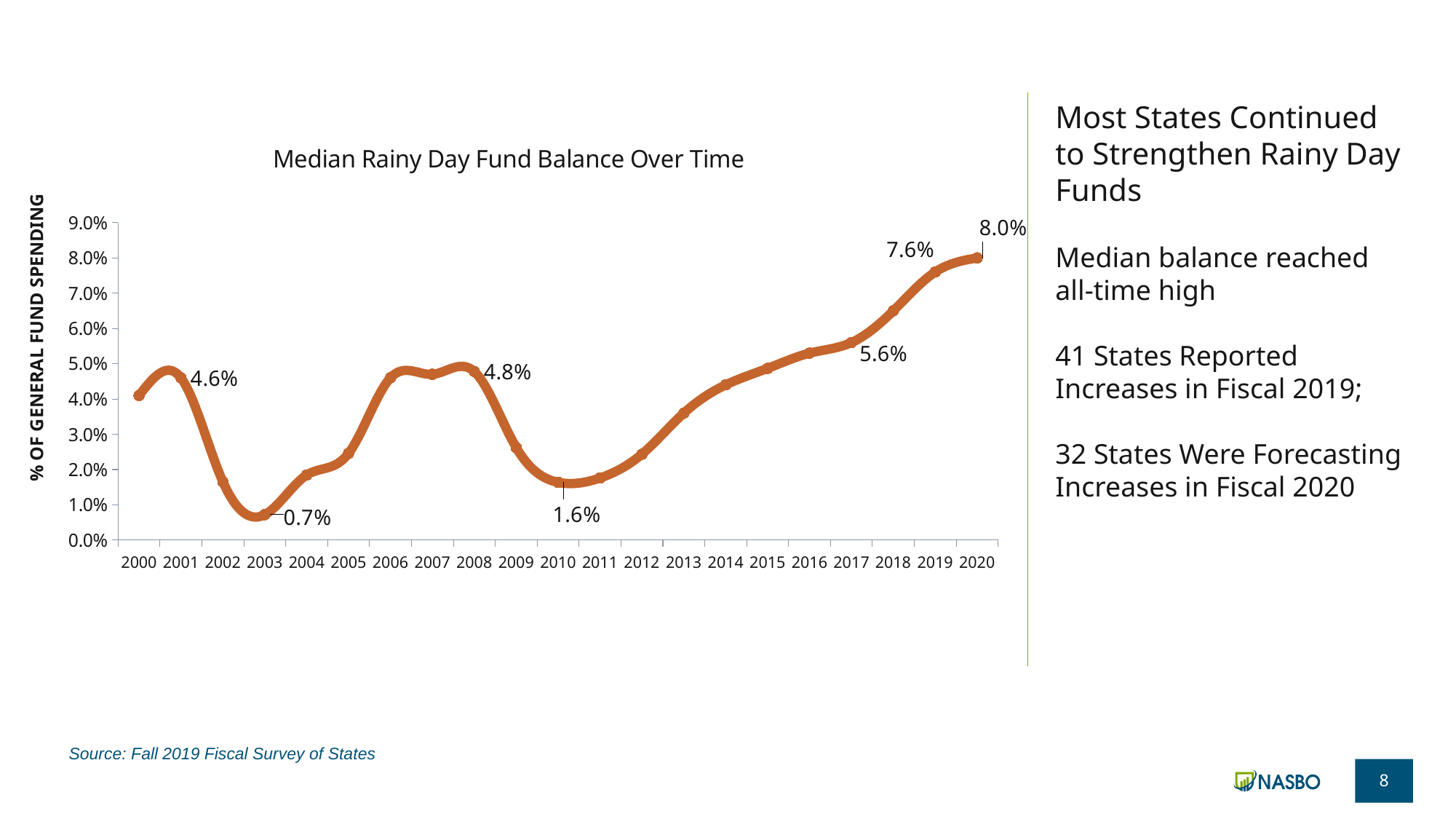
By how much did the median rainy day fund balance increase from 2019 to 2020? 0.4% How many years are plotted on the x axis? 21 Which year had a higher median balance, 2001 or 2008? 2008 Which year has the lowest median rainy day fund balance? 2003 Which year has the highest median rainy day fund balance? 2020 What is the median rainy day fund balance for 2010? 1.6% What is the median rainy day fund balance for 2003? 0.7% What is the difference between the median balance in 2020 and in 2017? 2.4% What kind of chart is shown on the slide? line chart What is the median rainy day fund balance for 2017? 5.6% What is the median rainy day fund balance for 2020? 8.0% Is the median balance for 2005 greater or less than 3.0%? less